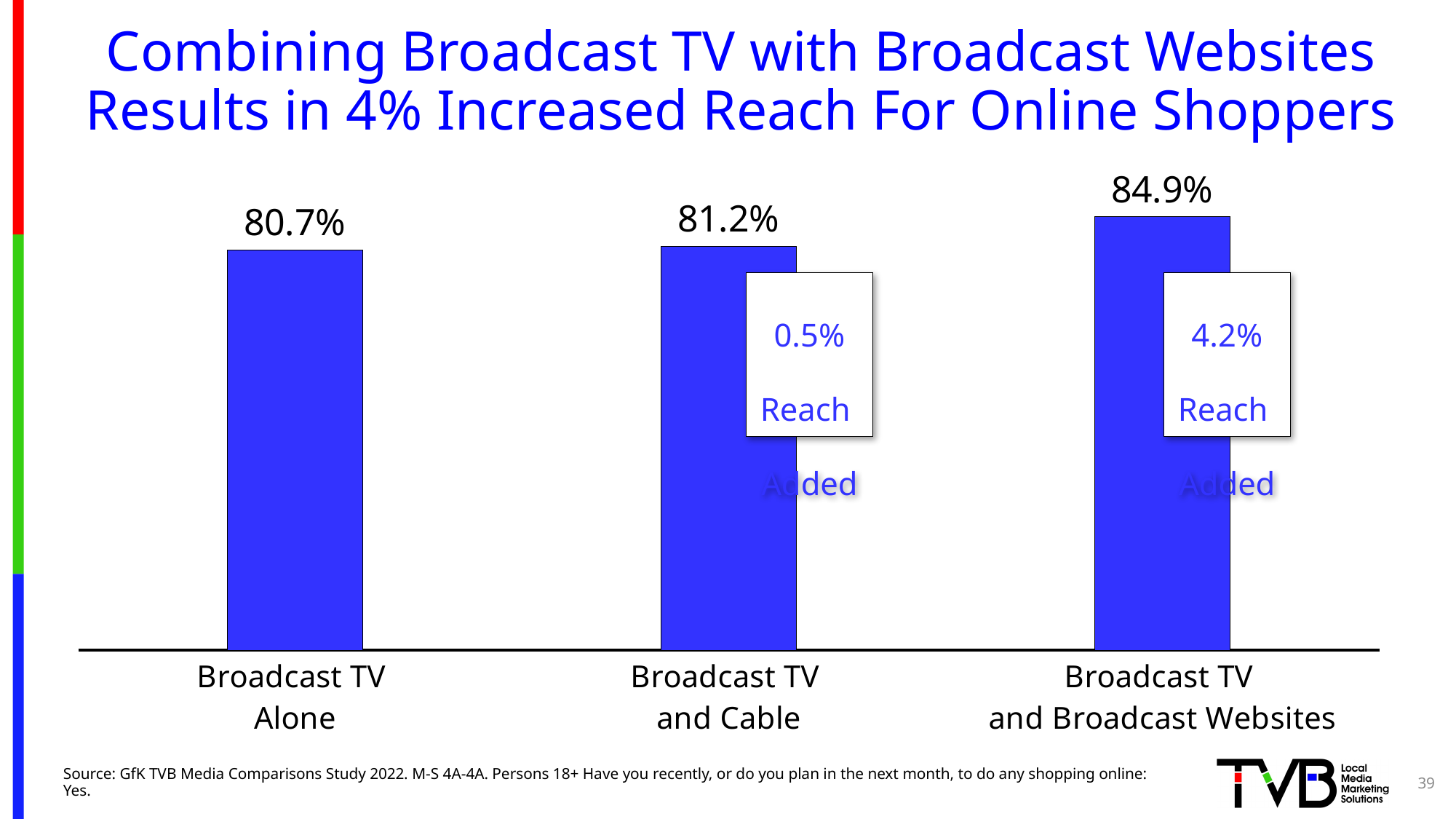
How many categories are shown in the chart? 3 What kind of chart is shown on the slide? Bar chart What is the difference between the values for Broadcast TV and Cable and Broadcast TV Alone? 0.5% Which category has the highest value? Broadcast TV and Broadcast Websites Which category has the lowest value? Broadcast TV Alone Do the values rise or fall from left to right across the categories? Rise Which is larger, the value for Broadcast TV and Broadcast Websites or the value for Broadcast TV and Cable? Broadcast TV and Broadcast Websites What is the value for Broadcast TV and Cable? 81.2% What reach added is shown in the callout box next to the Broadcast TV and Broadcast Websites bar? 4.2% What is the value for Broadcast TV and Broadcast Websites? 84.9% What is the value for Broadcast TV Alone? 80.7% What is the difference between the values for Broadcast TV and Broadcast Websites and Broadcast TV Alone? 4.2%